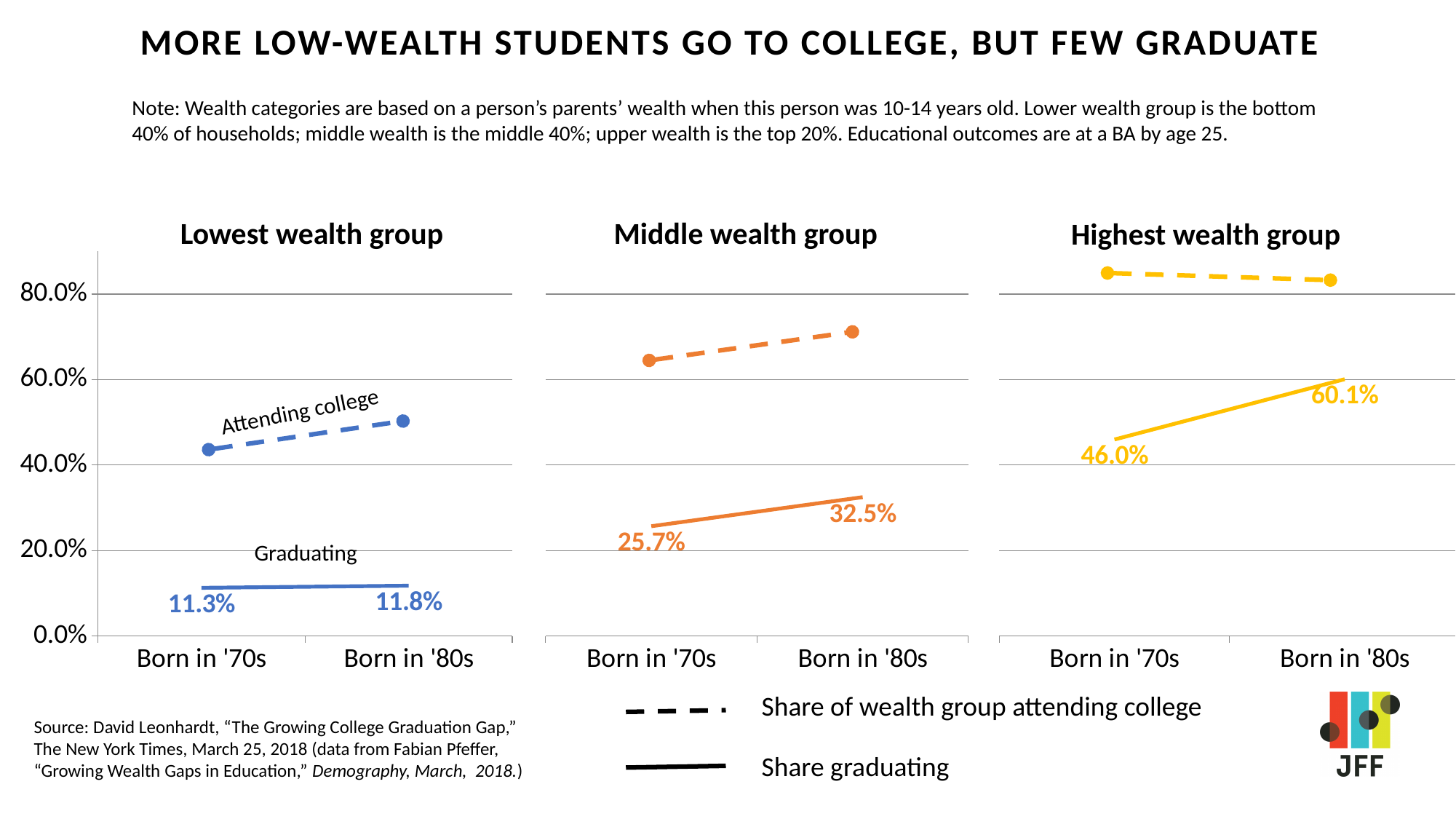
In the Highest wealth group chart, is the share attending college for those born in the '70s greater or less than 80.0%? greater How many series does the legend list? 2 In the Middle wealth group chart, is the share attending college for those born in the '80s greater or less than 80.0%? less In the Lowest wealth group chart, what is the share graduating for those born in the '70s? 11.3% In the Lowest wealth group chart, is the share attending college for those born in the '70s greater or less than 40.0%? greater In the Middle wealth group chart, what is the share graduating for those born in the '80s? 32.5% In the Lowest wealth group chart, what is the share graduating for those born in the '80s? 11.8% In the Highest wealth group chart, what is the share graduating for those born in the '70s? 46.0% What kind of chart is the Highest wealth group chart? line chart In the Middle wealth group chart, what is the difference in share graduating between those born in the '80s and those born in the '70s? 6.8% In the Middle wealth group chart, does the share graduating rise or fall from those born in the '70s to those born in the '80s? rise In the Highest wealth group chart, what is the difference in share graduating between those born in the '80s and those born in the '70s? 14.1%